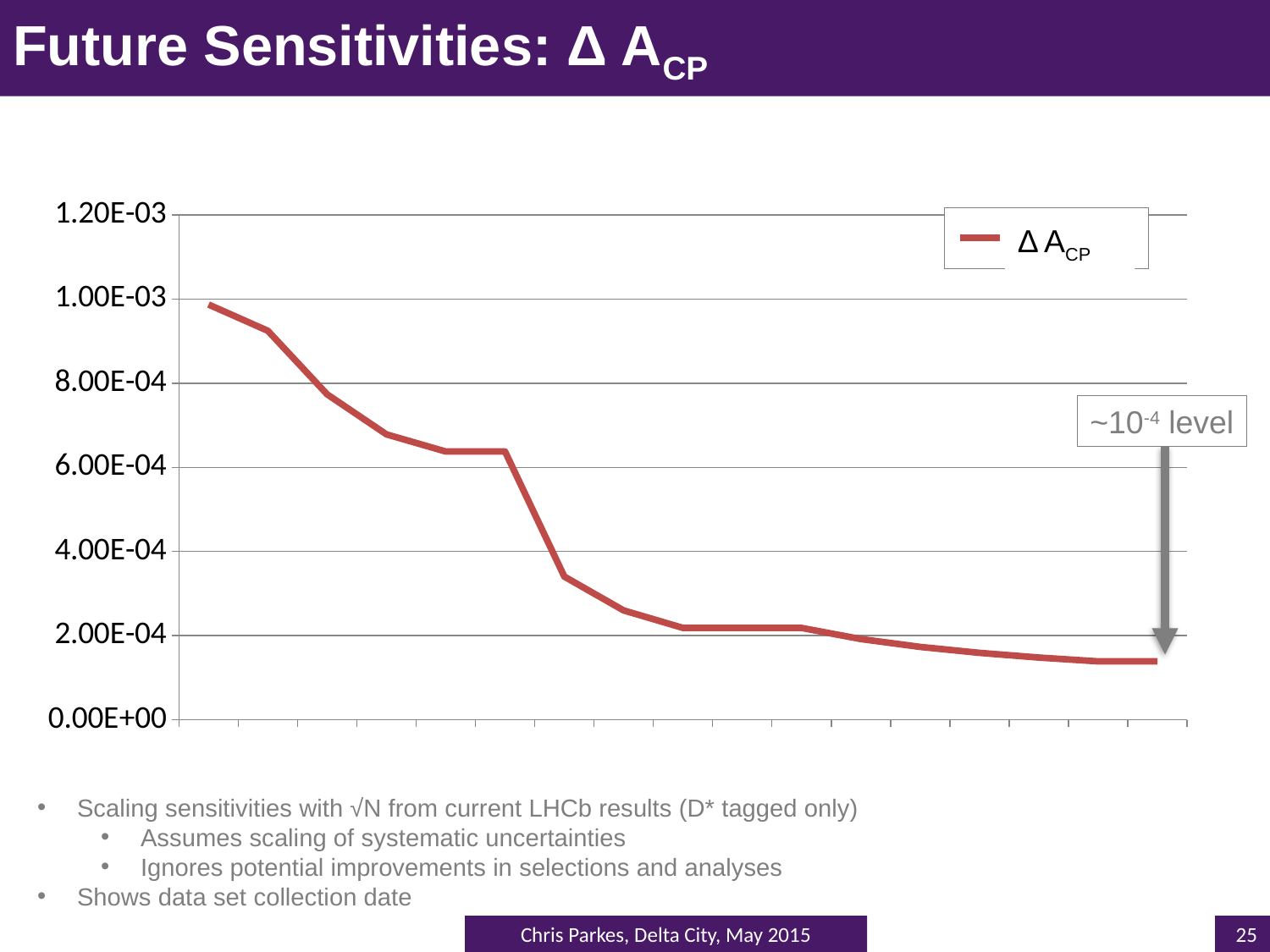
How many series does the chart legend list? 1 Do the values of Δ A_CP rise or fall from left to right along the x axis? fall Is the leftmost value of Δ A_CP greater or less than 6.00E-04? greater Is the rightmost (last) value of Δ A_CP greater or less than 2.00E-04? less Is the leftmost (first) value of Δ A_CP greater or less than 8.00E-04? greater Which is larger, the first value of Δ A_CP or the last value? the first value What is the name of the series shown in the chart legend? Δ A_CP What kind of chart is shown on the slide? line chart What is the highest tick value shown on the y axis? 1.20E-03